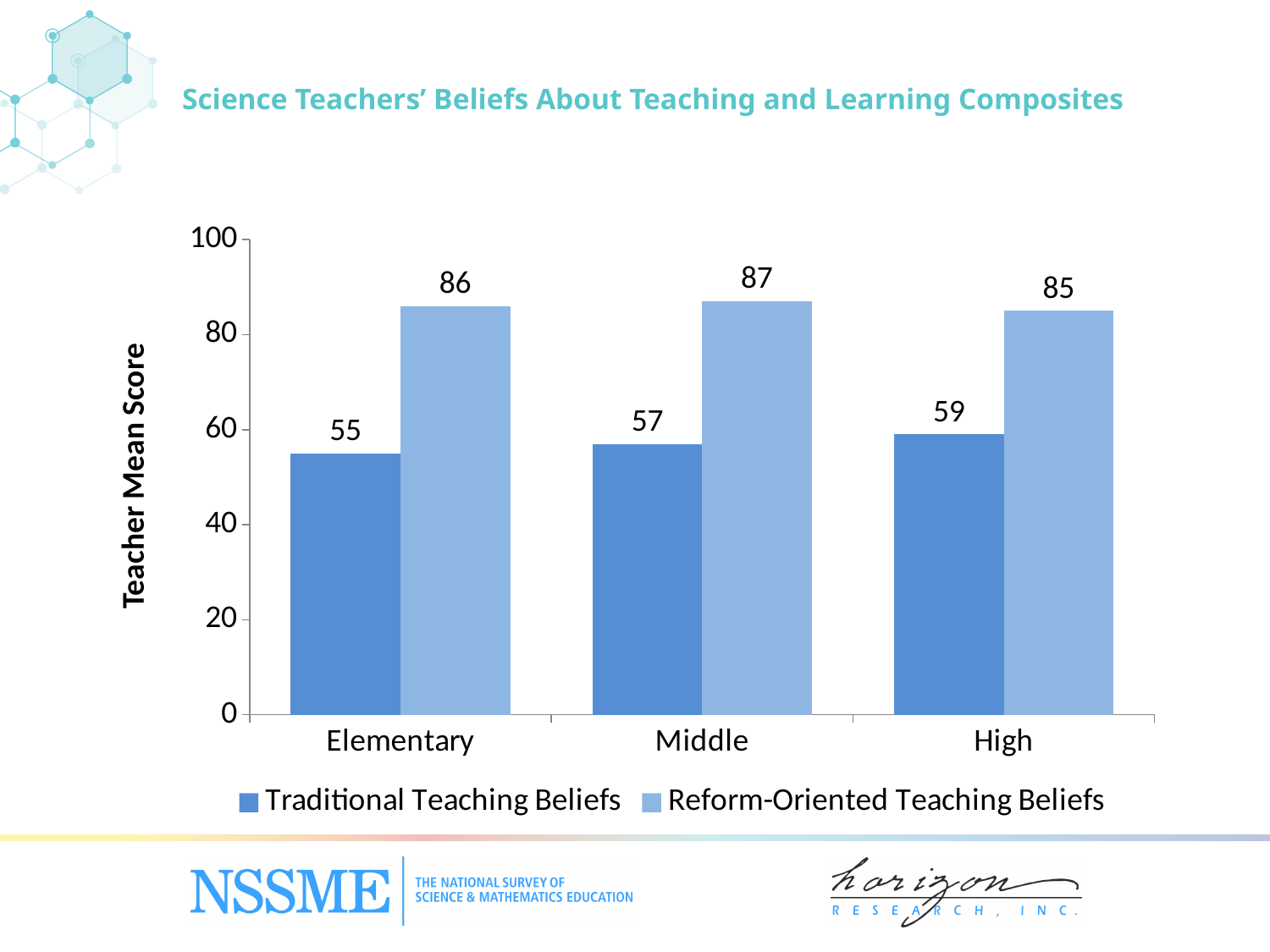
Which grade level has the lowest Reform-Oriented Teaching Beliefs mean score? High How many grade-level categories are shown on the x axis? 3 Which grade level has the highest Traditional Teaching Beliefs mean score? High What kind of chart is shown on the slide? bar chart What is the Traditional Teaching Beliefs mean score for Elementary teachers? 55 Which is larger for Middle school teachers: the Traditional Teaching Beliefs score or the Reform-Oriented Teaching Beliefs score? Reform-Oriented Teaching Beliefs Is the Traditional Teaching Beliefs mean score for High school teachers greater or less than 60? less What is the Reform-Oriented Teaching Beliefs mean score for Middle school teachers? 87 What is the Reform-Oriented Teaching Beliefs mean score for High school teachers? 85 What is the difference between the Reform-Oriented and Traditional Teaching Beliefs mean scores for Elementary teachers? 31 What is the label of the vertical axis? Teacher Mean Score How many series does the legend list? 2